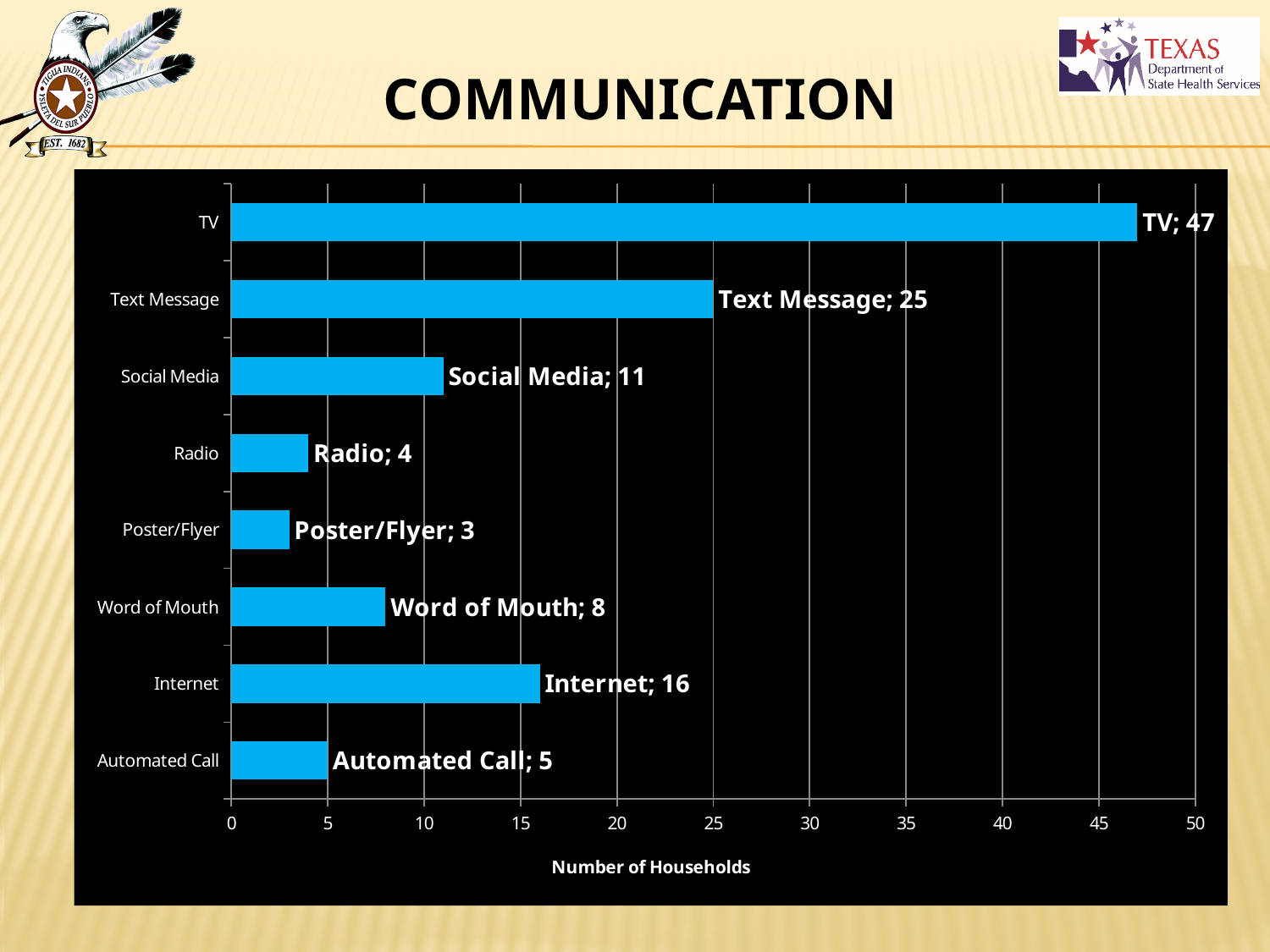
Which communication method has the lowest number of households? Poster/Flyer What is the number of households for Social Media? 11 How many communication methods are shown in the chart? 8 How many households reported TV as a communication method? 47 Which has more households, Radio or Automated Call? Automated Call What is the label of the horizontal axis? Number of Households What type of chart is shown on the slide? Bar chart What is the difference between Internet and Word of Mouth? 8 What is the difference in number of households between TV and Text Message? 22 Which has more households, Internet or Social Media? Internet What is the value for Automated Call? 5 Which communication method has the highest number of households? TV